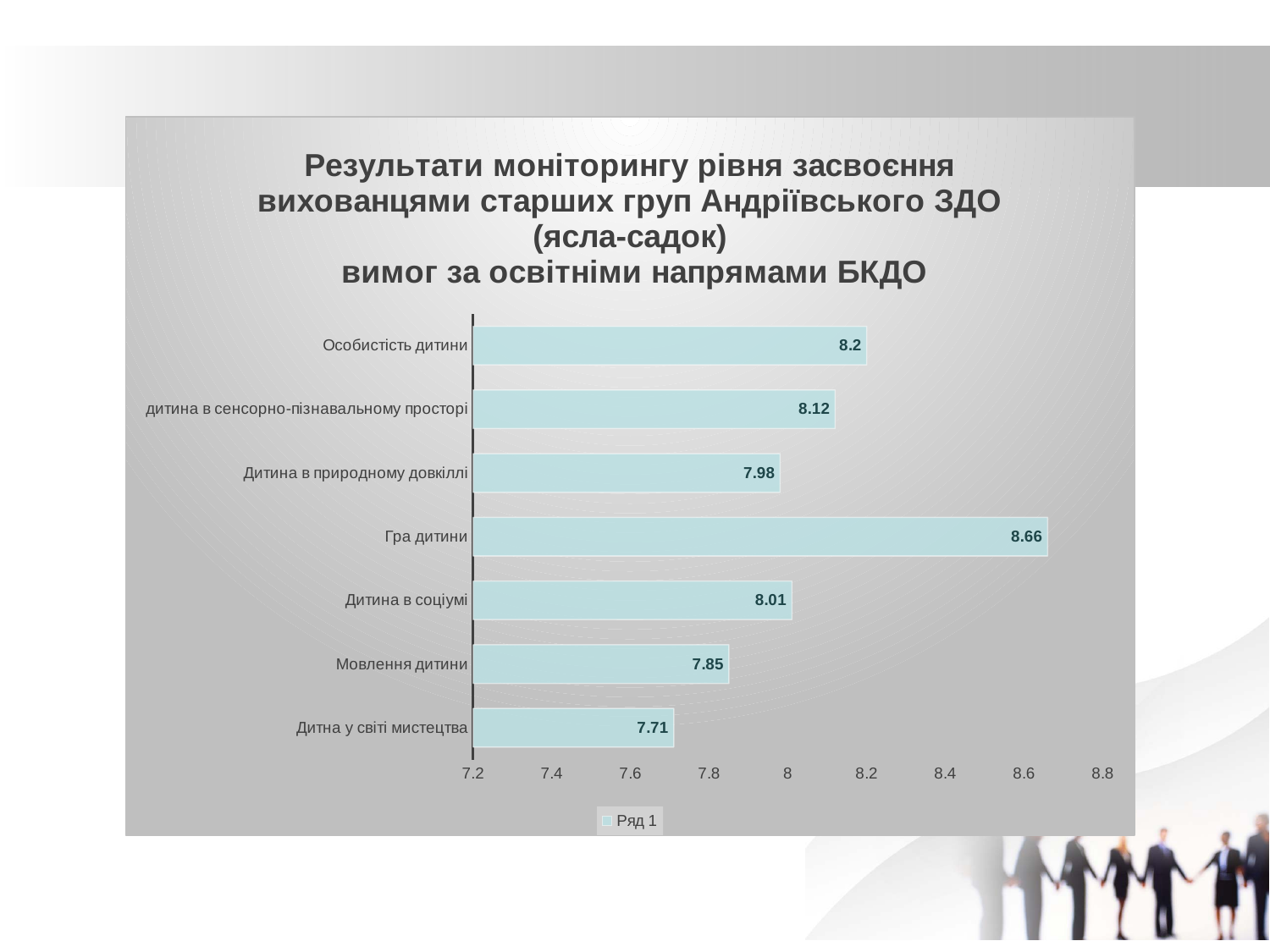
Which category has the lowest value? Дитна у світі мистецтва What is the value for Мовлення дитини? 7.85 What is the difference between the values for Особистість дитини and Дитина в соціумі? 0.19 What is the value for Дитина в природному довкіллі? 7.98 How many categories are shown in the chart? 7 What kind of chart is shown on the slide? bar chart Is the value for Дитина в соціумі greater or less than 8? greater Which category has the highest value? Гра дитини What is the difference between the values for Гра дитини and Дитна у світі мистецтва? 0.95 Which is larger, the value for Особистість дитини or the value for дитина в сенсорно-пізнавальному просторі? Особистість дитини What series name does the legend show? Ряд 1 What is the value for Гра дитини? 8.66